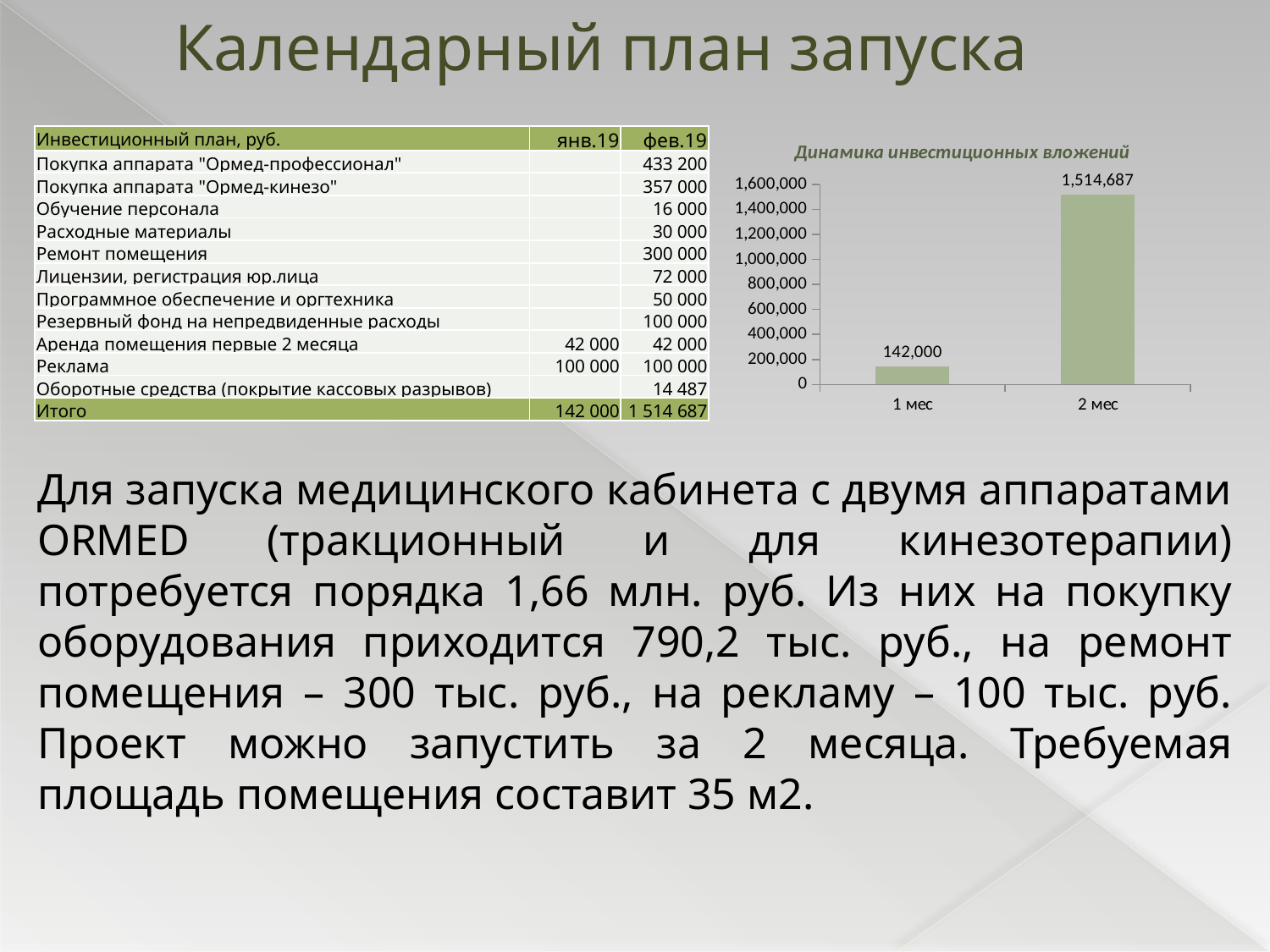
Which category has the lowest value in the chart? 1 мес How many categories are shown on the x axis of the chart? 2 Which category has the highest value in the chart? 2 мес Do the values rise or fall from 1 мес to 2 мес? rise Which is larger, the value for 1 мес or the value for 2 мес? 2 мес Is the value for 1 мес greater or less than 200,000? less What is the value for 2 мес in the chart? 1,514,687 Is the value for 2 мес greater or less than 1,400,000? greater What is the difference between the values for 2 мес and 1 мес? 1,372,687 What is the value for 1 мес in the chart? 142,000 What is the title of the chart? Динамика инвестиционных вложений What kind of chart is shown on the slide? bar chart